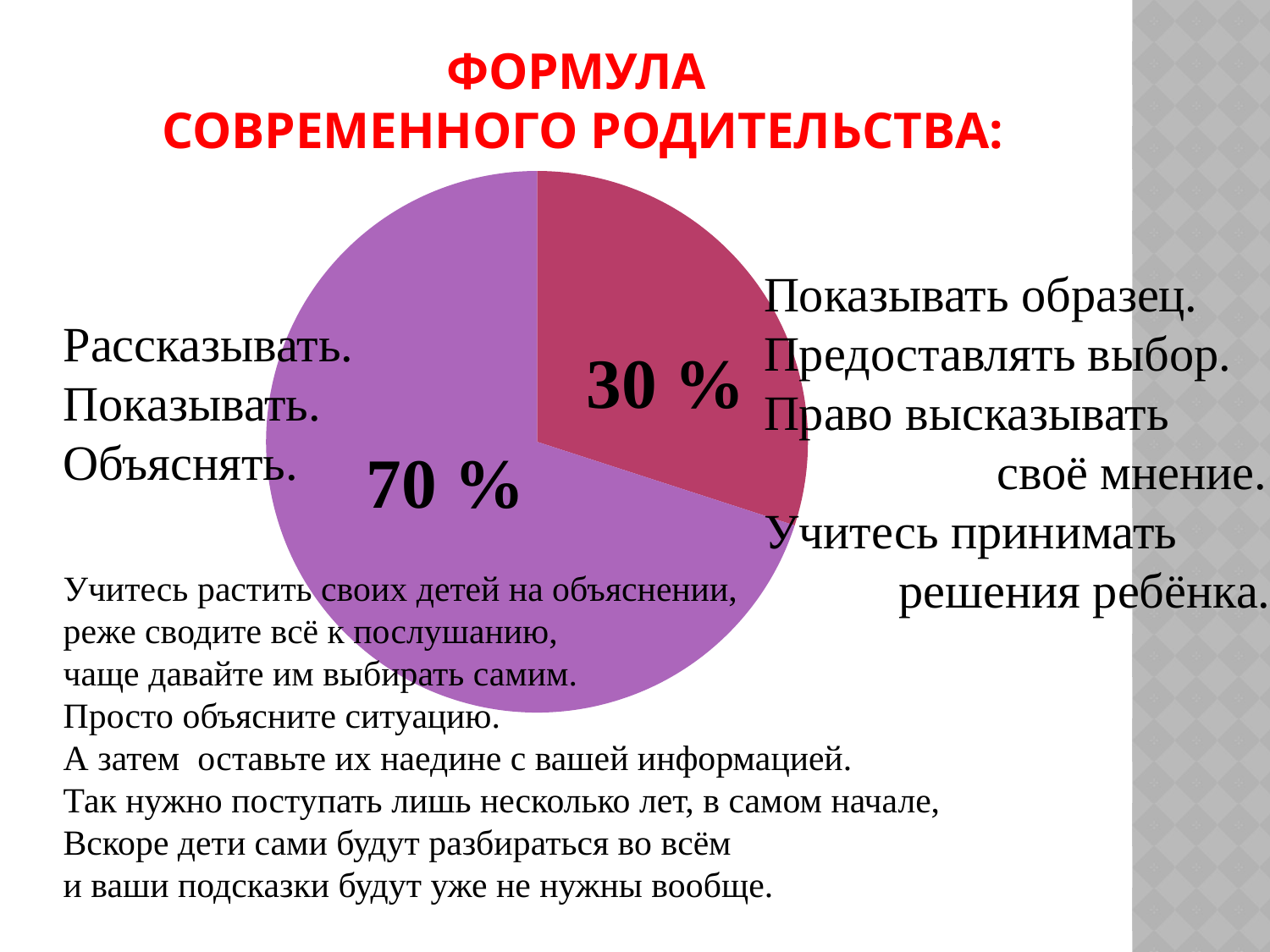
Which slice of the pie chart is the smallest? the red slice (30 %) What is the title of the slide containing the pie chart? ФОРМУЛА СОВРЕМЕННОГО РОДИТЕЛЬСТВА: What is the difference between the two slice values in the pie chart? 40 % What colour is the 30 % slice of the pie chart? red Which is larger in the pie chart, the purple slice or the red slice? the purple slice What do the two slice values of the pie chart add up to? 100 % How many slices does the pie chart have? 2 Which slice of the pie chart is the largest? the purple slice (70 %) Is the value of the red slice greater or less than 50 %? less What kind of chart is shown on the slide? pie chart What percentage is printed on the red slice of the pie chart? 30 % What percentage is printed on the purple slice of the pie chart? 70 %